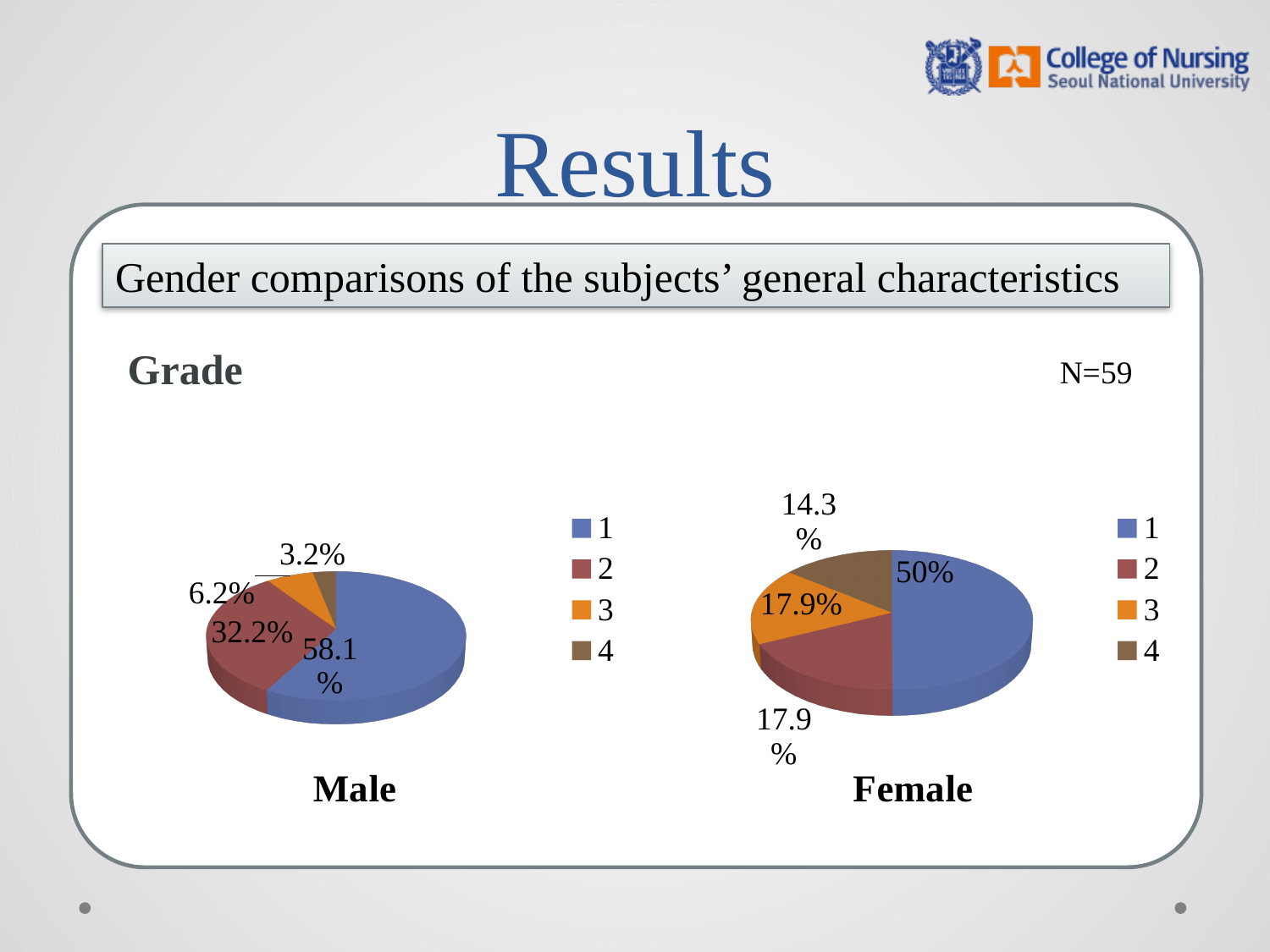
In the Male pie chart, which grade has the largest share? 1 In the Male pie chart, what percentage is shown for grade 2? 32.2% How many entries does the legend of the Female pie chart list? 4 In the Female pie chart, what percentage is shown for grade 4? 14.3% In the Male pie chart, what percentage is shown for grade 4? 3.2% In the Female pie chart, what percentage is shown for grade 1? 50% What type of chart is used for the Male and Female grade distributions? Pie chart In the Male pie chart, which grade has the smallest share? 4 In the Female pie chart, which grade has the smallest share? 4 In the Male pie chart, what percentage is shown for grade 1? 58.1% Which is larger: the grade 1 share in the Male chart or the grade 1 share in the Female chart? Male In the Male pie chart, what is the difference in percentage points between grade 1 and grade 2? 25.9